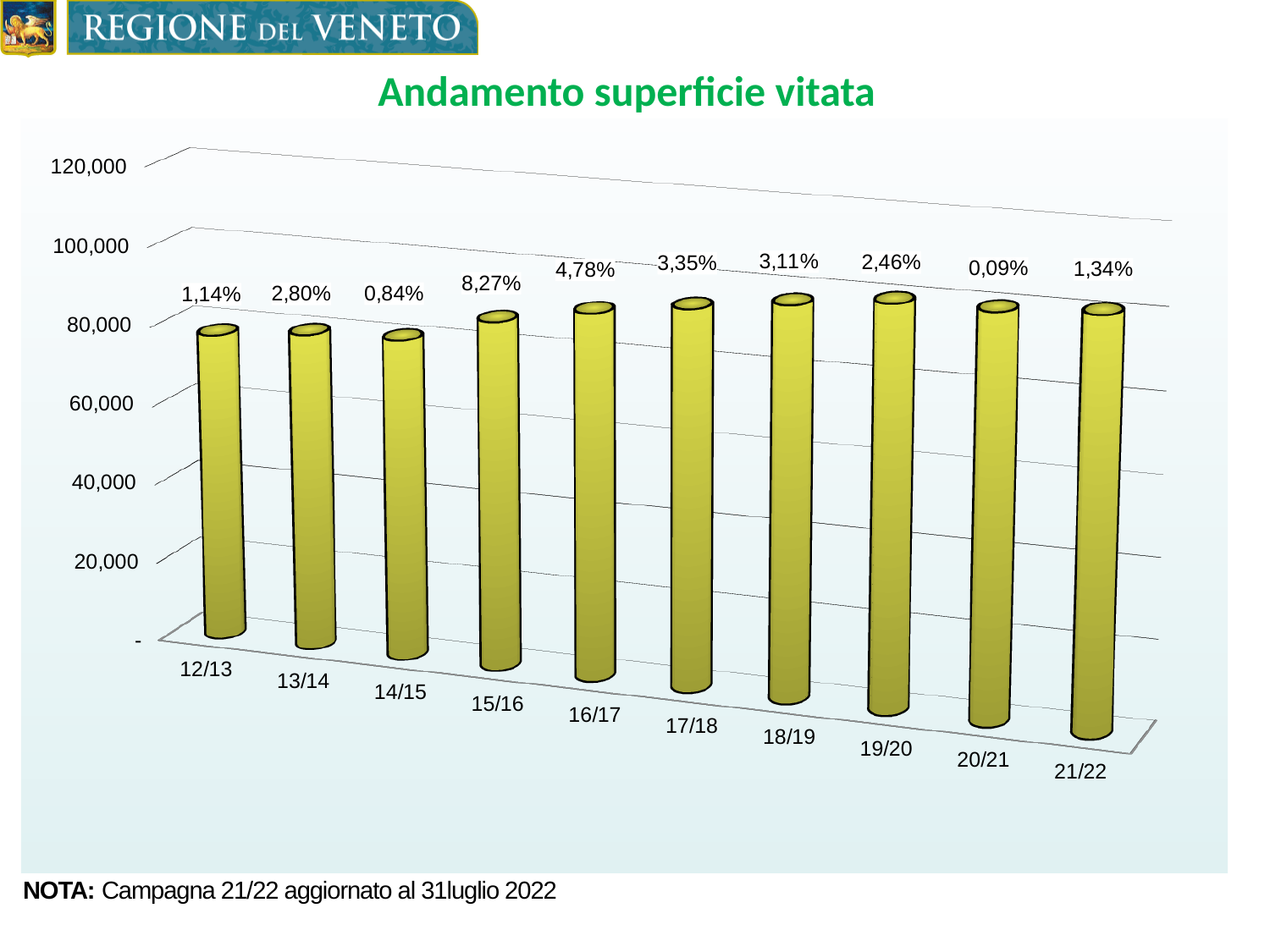
Which has the larger percentage label, 16/17 or 17/18? 16/17 What percentage label is shown above the bar for 21/22? 1,34% How many campaign years (categories) are shown on the x axis? 10 Which campaign year has the lowest percentage label? 20/21 Is the value for 12/13 greater or less than 100,000? less What type of chart is shown on the slide? bar chart What is the title of the chart? Andamento superficie vitata Is the value for 19/20 greater or less than 60,000? greater Which campaign year has the highest percentage label? 15/16 What percentage label is shown above the bar for 20/21? 0,09% What percentage label is shown above the bar for 15/16? 8,27% What is the difference between the percentage labels for 15/16 and 14/15? 7,43%